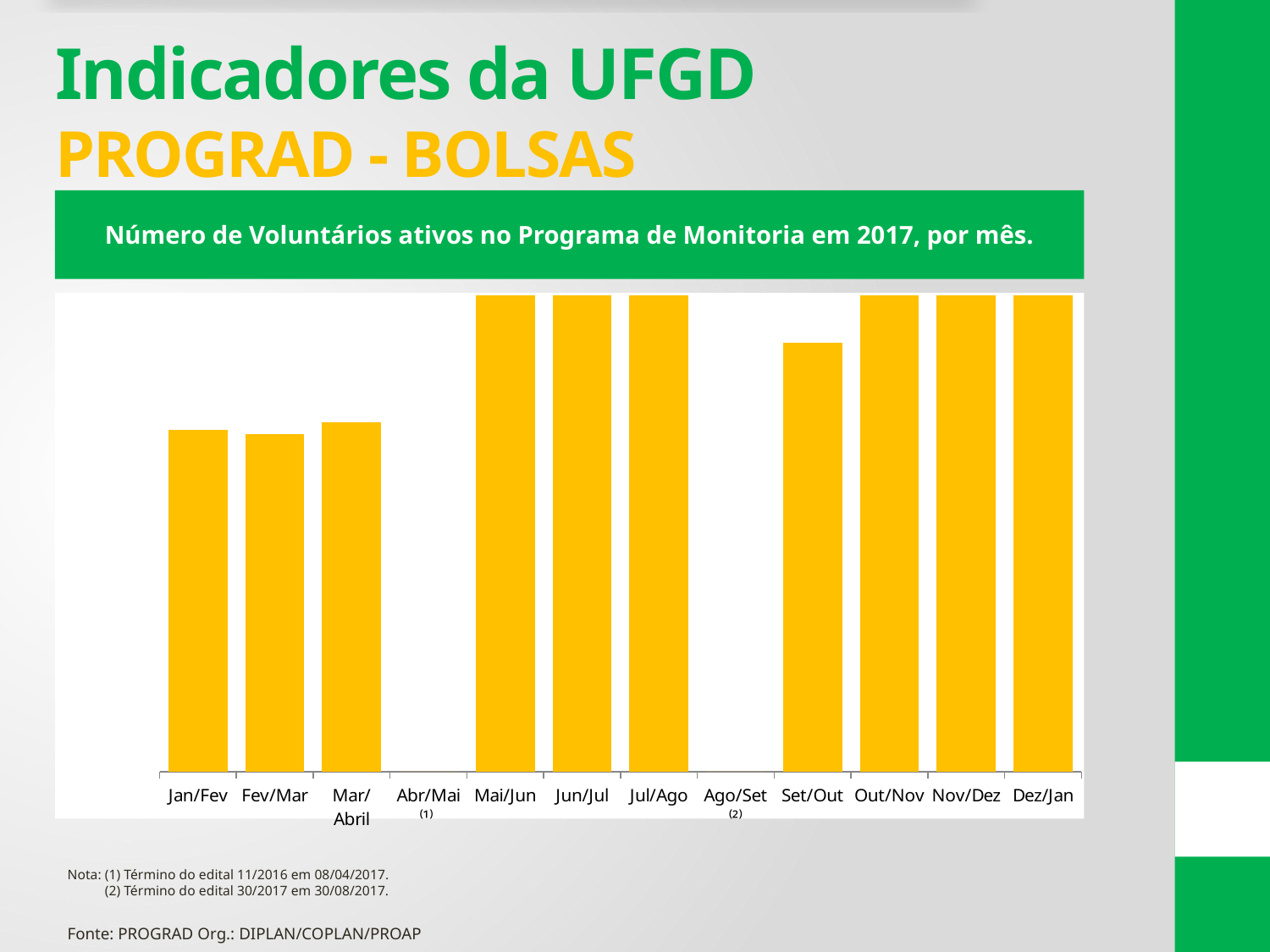
What kind of chart is shown on the slide? Bar chart How many bars reach the full height of the chart? 6 What is the title of the chart? Número de Voluntários ativos no Programa de Monitoria em 2017, por mês. Which is larger, the value for Mar/Abril or the value for Dez/Jan? Dez/Jan Which two categories on the x axis have no bar plotted? Abr/Mai and Ago/Set Which is larger, the value for Jul/Ago or the value for Set/Out? Jul/Ago Which is larger, the value for Fev/Mar or the value for Mar/Abril? Mar/Abril Do the values rise or fall from Set/Out to Out/Nov? Rise How many month-pair categories are labelled on the x axis of the chart? 12